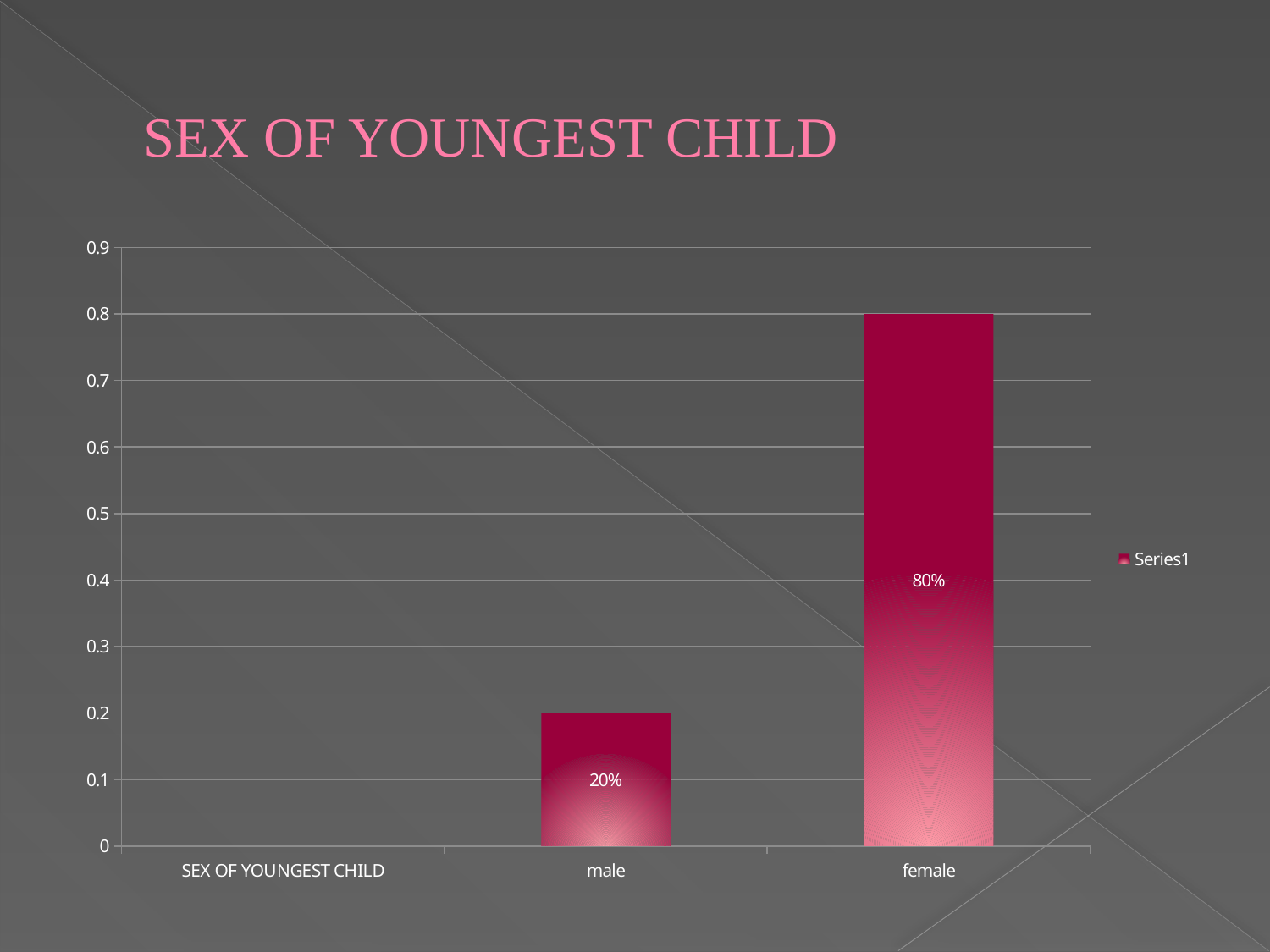
What kind of chart is shown on the slide? bar chart Is the value for female greater or less than 0.5? greater What is the difference between the female and male values? 60% Is the value for male greater or less than 0.3? less Which is larger, the value for male or the value for female? female What is the value shown for female? 80% Which category has the highest value? female What is the title of the slide? SEX OF YOUNGEST CHILD Which category has the lowest plotted value? male How many series does the legend list? 1 How many bars are plotted on the chart? 2 What is the value shown for male? 20%